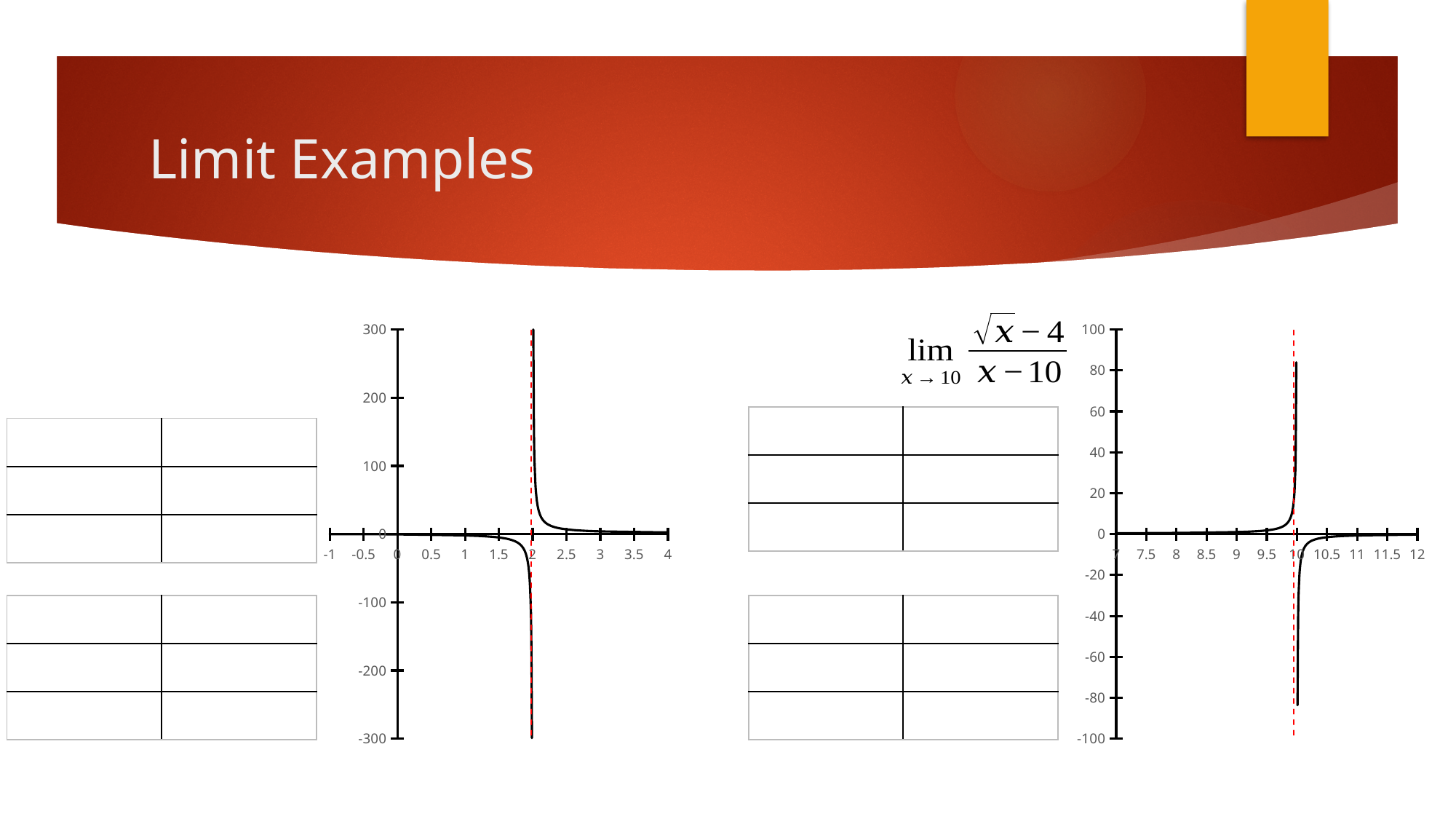
On the right chart, is the value of the curve at x = 8 greater or less than 20? less On the right chart, as x increases from 7 to 9.5, does the curve rise or fall? rise On the right chart, at what x value is the dashed red vertical line drawn? 10 On the right chart, which has the larger value: the curve at x = 9.5 or at x = 10.5? x = 9.5 On the left chart, is the value of the curve at x = 3 greater or less than 100? less What kind of chart is the left chart? line chart On the left chart, is the value of the curve at x = 1 greater or less than -100? greater On the left chart, which has the larger value: the curve at x = 2.5 or at x = 1.5? x = 2.5 On the left chart, as x increases from 2.5 to 4, does the curve rise or fall? fall What kind of chart is the right chart? line chart On the left chart, at what x value is the dashed red vertical line drawn? 2